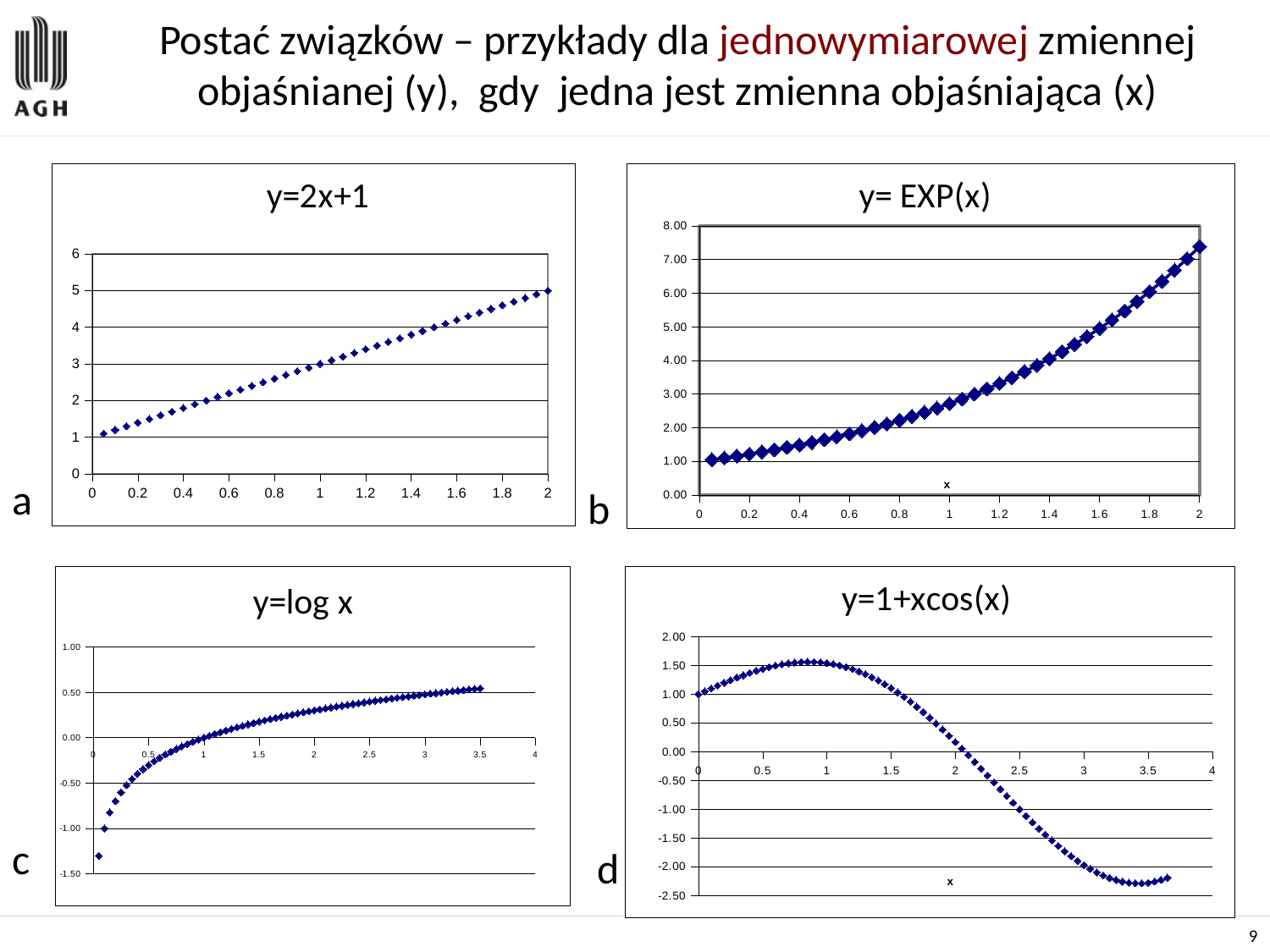
What kind of chart is the chart titled "y=2x+1"? scatter chart In the chart titled "y= EXP(x)", is the value at x = 1 greater or less than 2.00? greater In the chart titled "y=2x+1", do the values rise or fall as x increases? rise In the chart titled "y=1+xcos(x)", is the lowest plotted value greater or less than -2.00? less How many charts are shown on the slide? 4 In the chart titled "y=2x+1", what is the y value at x = 1? 3 In the chart titled "y=2x+1", what is the y value at x = 2? 5 In the chart titled "y= EXP(x)", is the value at x = 2 greater or less than 7.00? greater What is the title of the bottom-right chart? y=1+xcos(x) In the chart titled "y=log x", do the values rise or fall as x increases? rise In the chart titled "y= EXP(x)", do the values rise or fall as x increases? rise